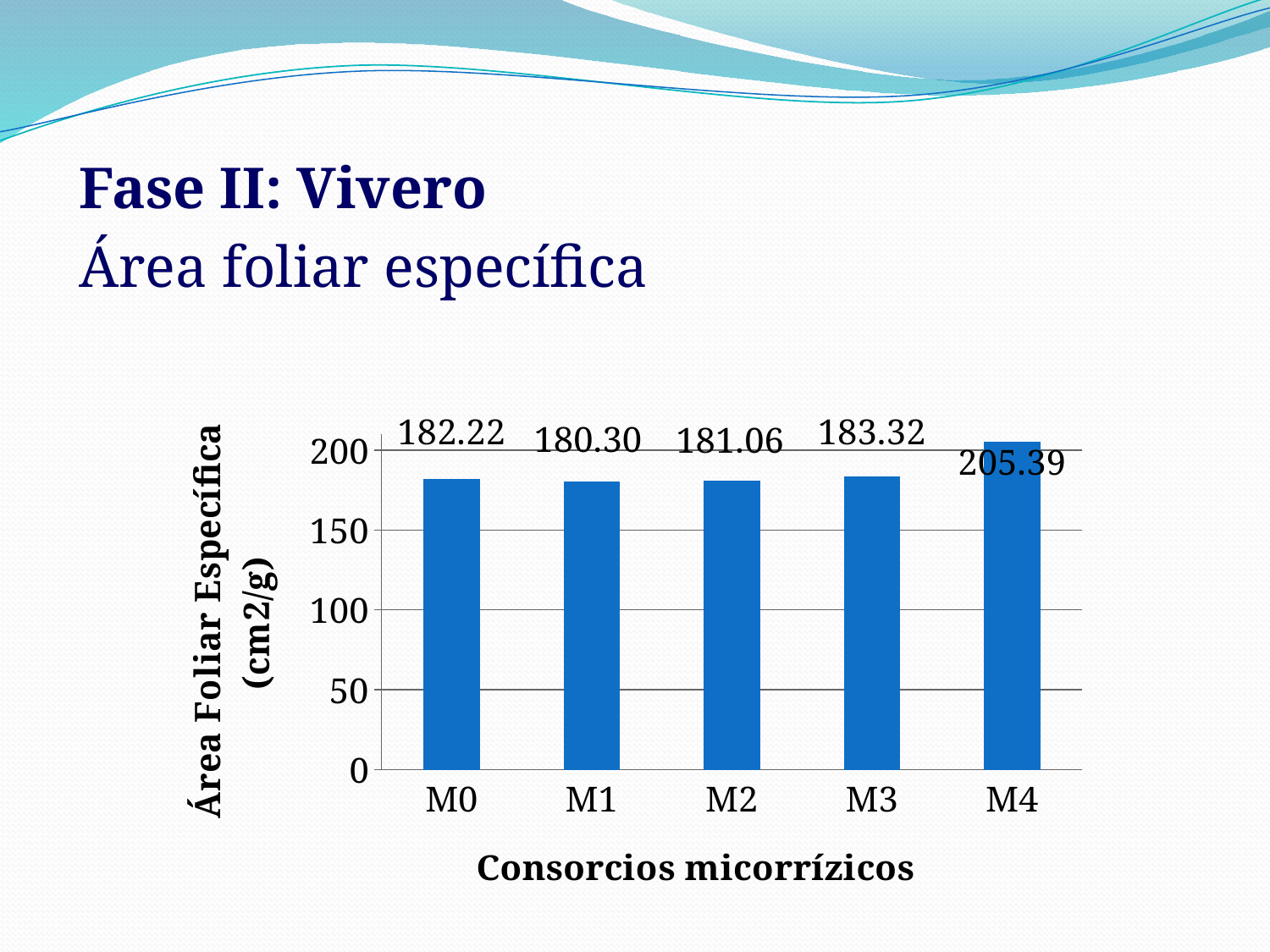
What is the label of the x axis? Consorcios micorrízicos What is the value for M4? 205.39 What is the value for M0? 182.22 What is the value for M1? 180.30 Which consorcio micorrízico has the lowest Área Foliar Específica? M1 What is the difference between the values for M4 and M0? 23.17 Which has a larger value, M3 or M2? M3 Which consorcio micorrízico has the highest Área Foliar Específica? M4 How many categories are shown on the x axis? 5 Is the value for M4 greater or less than 200? greater What kind of chart is shown? bar chart What unit is given in the y-axis label? cm2/g